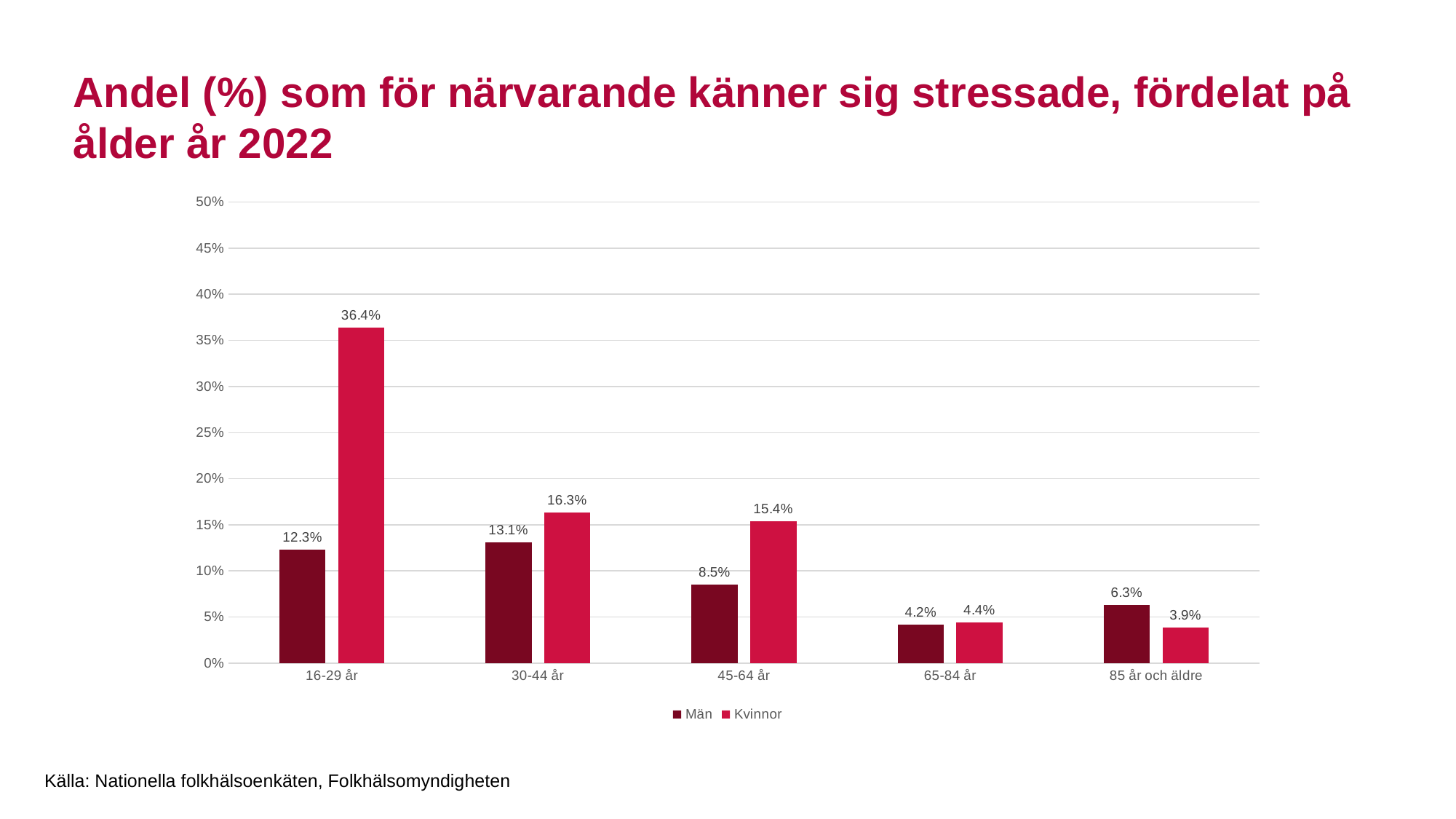
What is the value for Män in the 45-64 år age group? 8.5% Which is larger in the 85 år och äldre age group, the value for Män or for Kvinnor? Män How many age groups are shown on the x axis? 5 Which age group has the lowest value for Män? 65-84 år What is the value for Kvinnor in the 85 år och äldre age group? 3.9% What is the value for Kvinnor in the 16-29 år age group? 36.4% Which age group has the highest value for Kvinnor? 16-29 år What is the difference between the Kvinnor and Män values in the 16-29 år age group? 24.1% How many series does the legend list? 2 Do the Kvinnor values rise or fall from the 16-29 år group to the 85 år och äldre group? Fall What kind of chart is shown on the slide? Bar chart Is the value for Kvinnor in the 30-44 år age group greater or less than 15%? greater